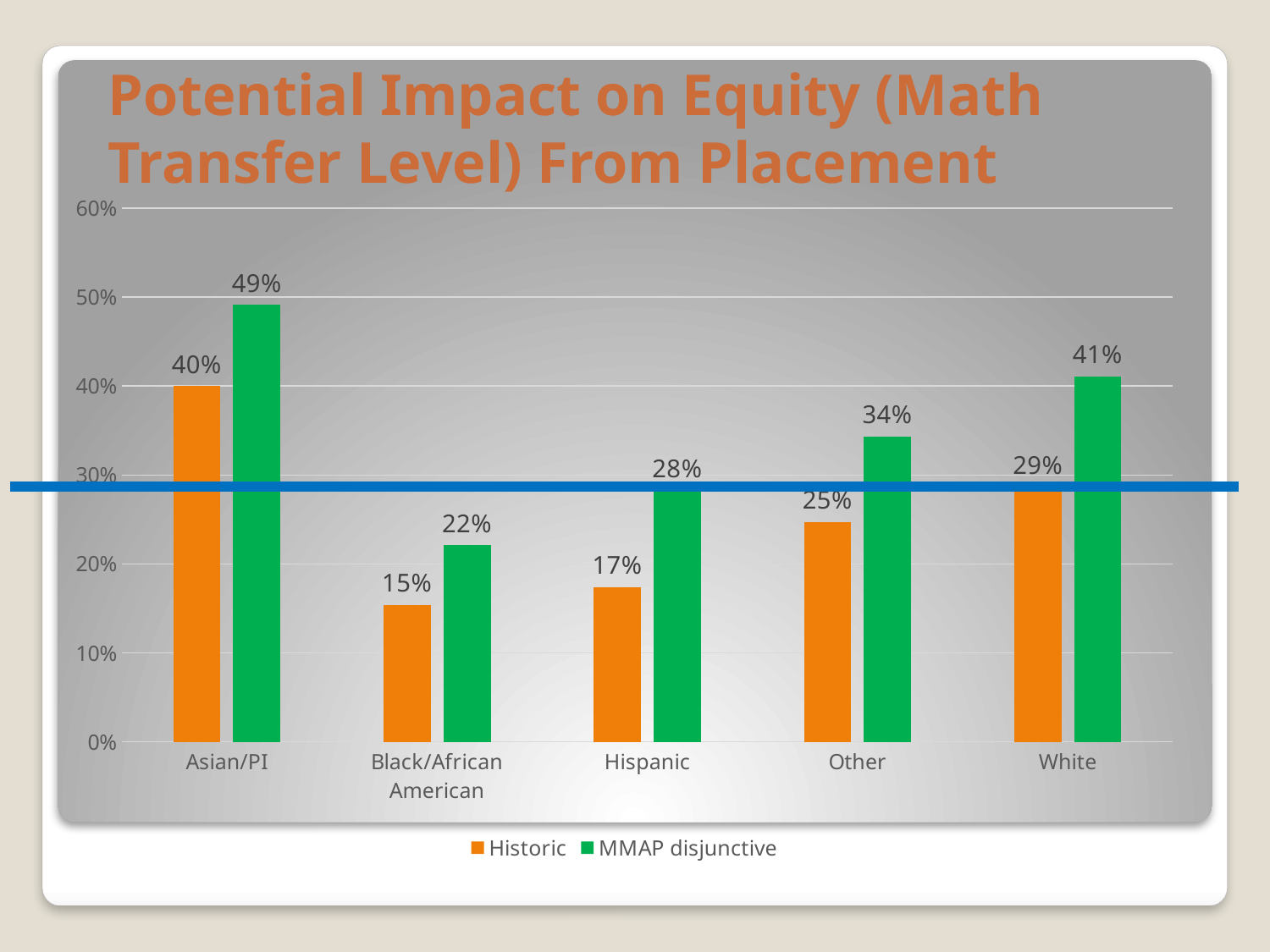
What colour are the MMAP disjunctive bars? Green What is the difference between the MMAP disjunctive and Historic values for Other? 9% Is the MMAP disjunctive value for White greater or less than 30%? greater What is the Historic value for Asian/PI? 40% Which category has the highest MMAP disjunctive value? Asian/PI What is the Historic value for White? 29% Which is larger for Black/African American: the Historic value or the MMAP disjunctive value? MMAP disjunctive What is the MMAP disjunctive value for Hispanic? 28% How many series does the legend list? 2 Which category has the lowest Historic value? Black/African American What kind of chart is shown on the slide? Bar chart How many categories are shown on the x axis? 5